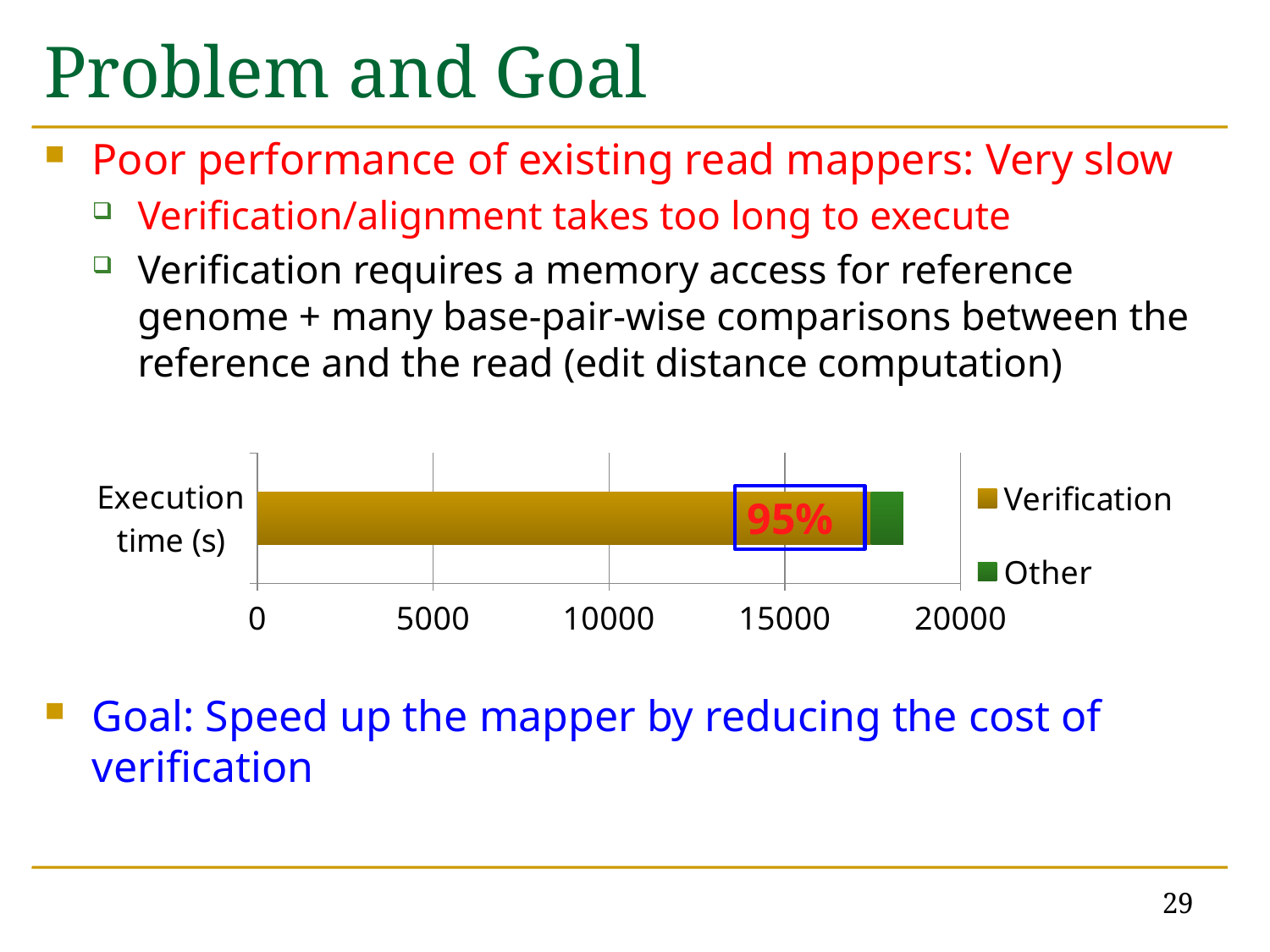
What is the highest value shown on the chart's horizontal axis? 20000 What is the label of the single category on the chart's vertical axis? Execution time (s) Is the total length of the Execution time bar greater or less than 20000? less How many categories are plotted on the chart's vertical axis? 1 Which series has the smallest share of the Execution time bar? Other What are the two series named in the chart's legend? Verification and Other Is the Other segment of the Execution time bar greater or less than 5000? less Is the Verification segment of the Execution time bar greater or less than 15000? greater What kind of chart is shown on the slide? bar chart What percentage label is printed on the Verification segment of the bar? 95% How many series does the chart's legend list? 2 Which series takes up the larger part of the Execution time bar, Verification or Other? Verification